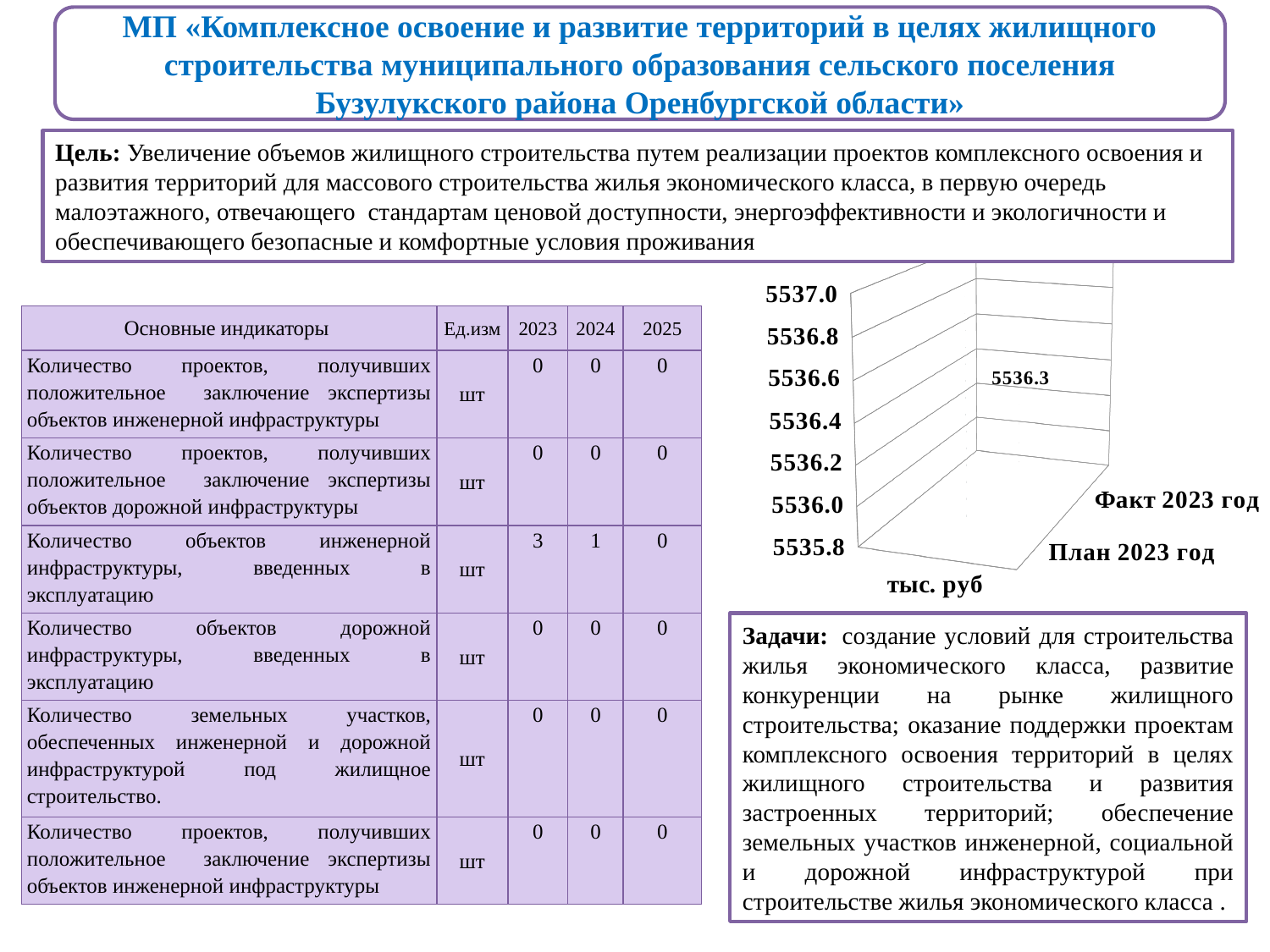
Is the data label value 5536.3 on the chart greater or less than 5537.0? less What is the lowest tick value shown on the chart's value axis? 5535.8 What is the only data label value printed on the chart? 5536.3 Is the data label value 5536.3 on the chart greater or less than 5536.0? greater How many categories are shown on the chart's category axis? 1 What is the highest tick value shown on the chart's value axis? 5537.0